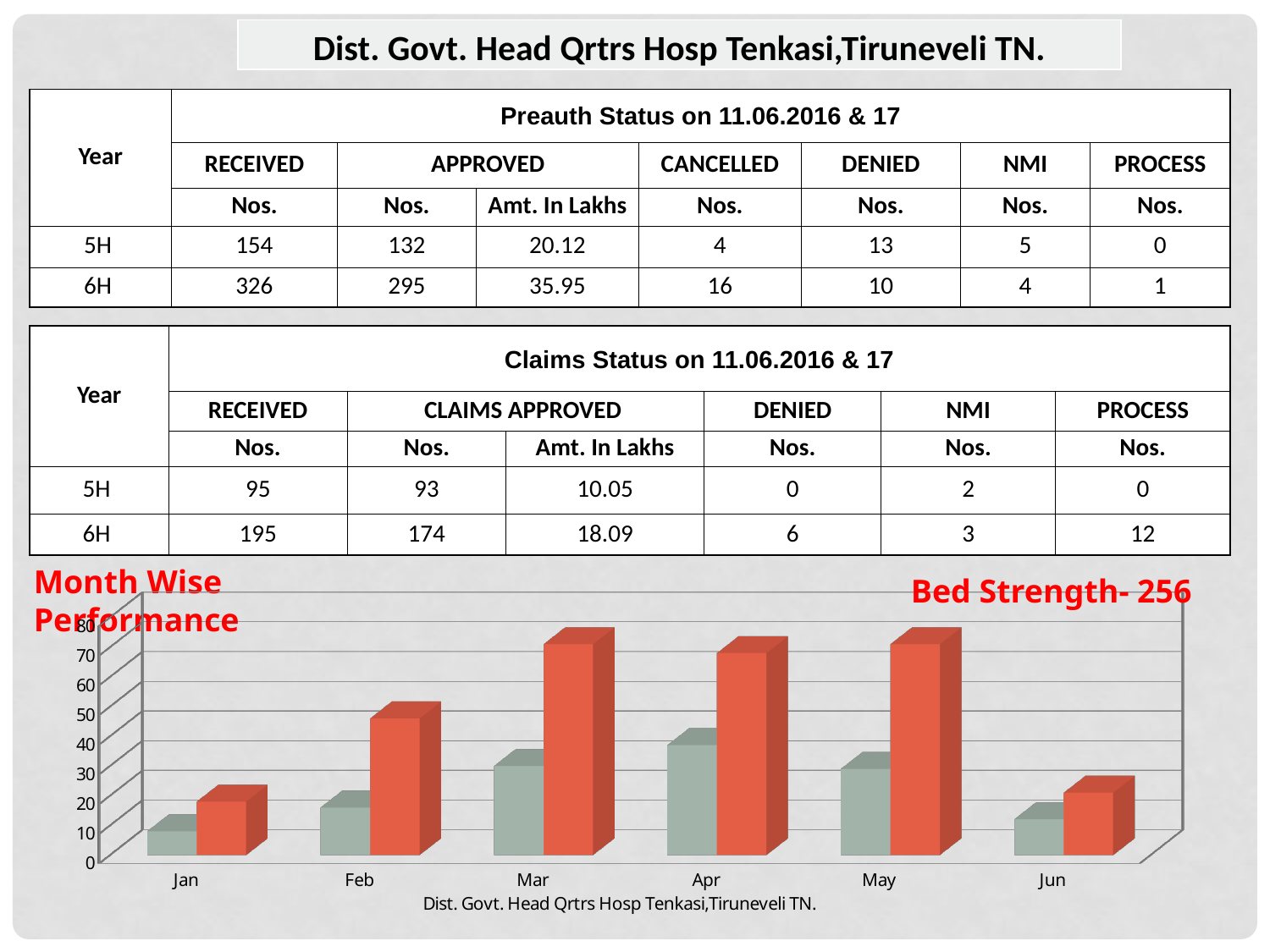
In the Month Wise Performance chart, is the grey bar for Jan greater or less than 20? less In the Month Wise Performance chart, is the red bar for Mar greater or less than 60? greater In the Month Wise Performance chart, which month has the tallest grey bar? Apr How many months are shown on the x axis of the Month Wise Performance chart? 6 In the Month Wise Performance chart, do the red bars rise or fall from Jan to Mar? rise In the Month Wise Performance chart, is the red bar for Jun greater or less than 30? less What text appears below the x axis of the Month Wise Performance chart? Dist. Govt. Head Qrtrs Hosp Tenkasi,Tiruneveli TN. What kind of chart is shown at the bottom of the slide? bar chart In the Month Wise Performance chart, which is larger: the red bar for Feb or the red bar for Mar? Mar In the Month Wise Performance chart, which month has the shortest grey bar? Jan How many bars are plotted for each month in the Month Wise Performance chart? 2